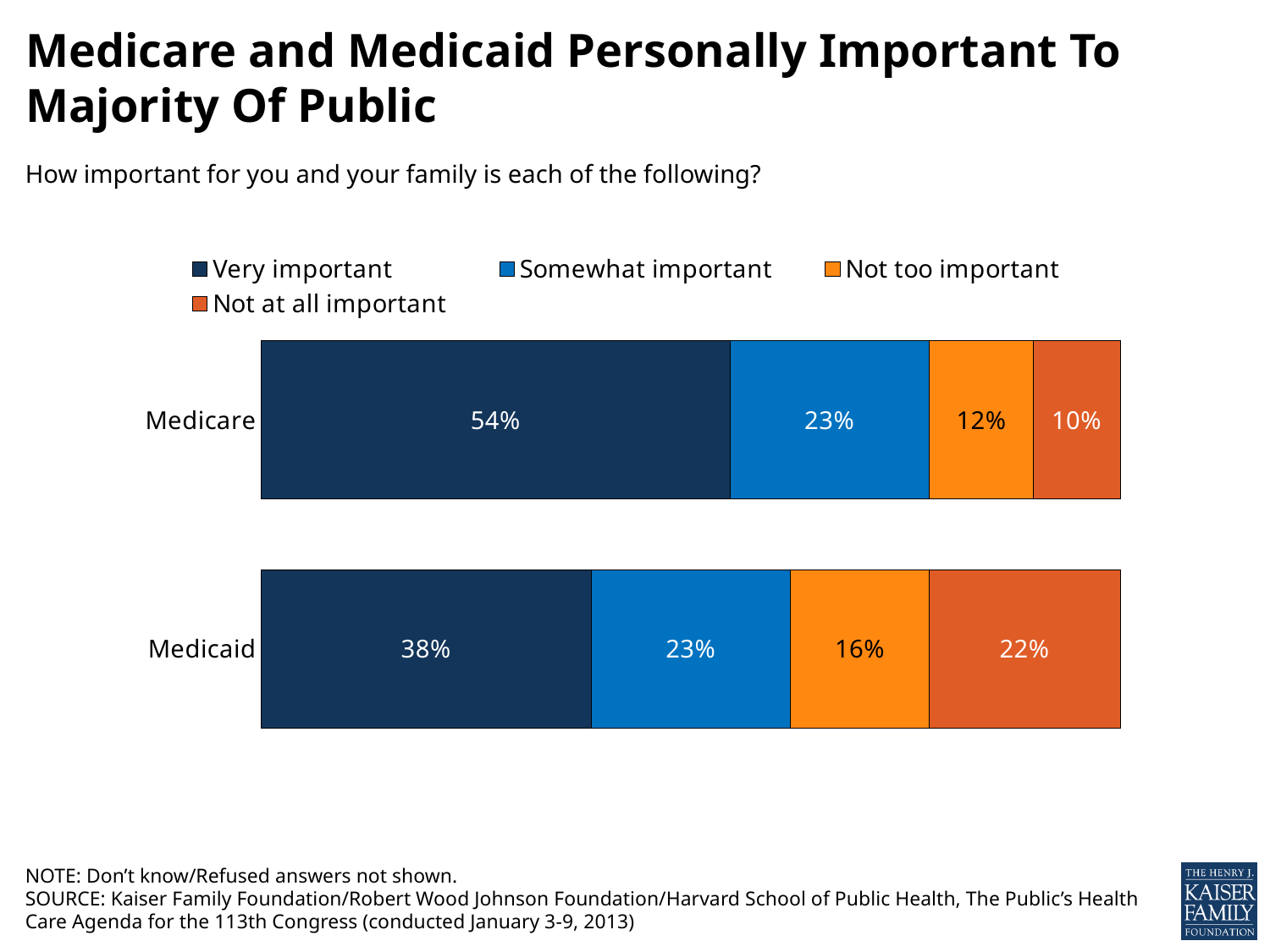
What kind of chart is shown on the slide? Stacked horizontal bar chart What is the total of the four labeled segments in the Medicare bar? 99% Which program has the higher share saying it is very important, Medicare or Medicaid? Medicare What is the difference between the not at all important shares for Medicaid and Medicare? 12 percentage points How many programs (categories) are shown in the chart? 2 What percentage says Medicaid is not at all important? 22% What percentage says Medicare is somewhat important? 23% What is the difference between the very important shares for Medicare and Medicaid? 16 percentage points What percentage of the public says Medicare is very important for them and their family? 54% What percentage says Medicaid is not too important? 16% What is the total of the four labeled segments in the Medicaid bar? 99% How many series does the legend list? 4